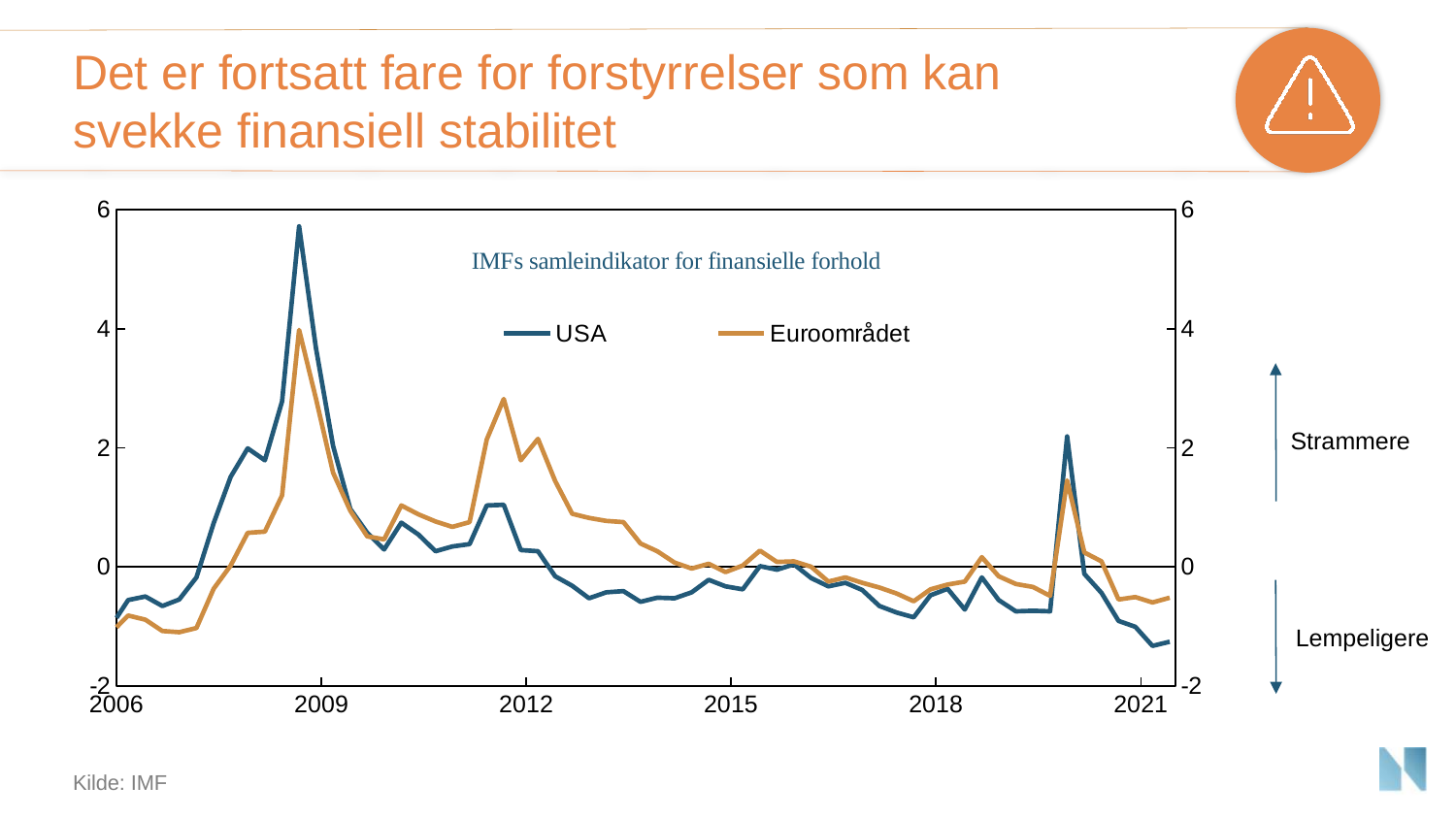
Is the peak value for USA around 2008–2009 greater or less than 4? greater Is the value for Euroområdet at the start of the series in 2006 greater or less than 0? less Is the peak value for Euroområdet around 2011–2012 greater or less than 2? greater At the peak around 2011–2012, which series is higher, USA or Euroområdet? Euroområdet Does the Euroområdet series rise or fall between 2012 and 2015? Fall At the spike around 2008–2009, which series reaches the higher value, USA or Euroområdet? USA What kind of chart is shown on the slide? Line chart At the spike in 2020, which series reaches the higher value, USA or Euroområdet? USA What are the two series named in the chart legend? USA and Euroområdet How many series does the chart legend list? 2 What is the title of the chart? IMFs samleindikator for finansielle forhold